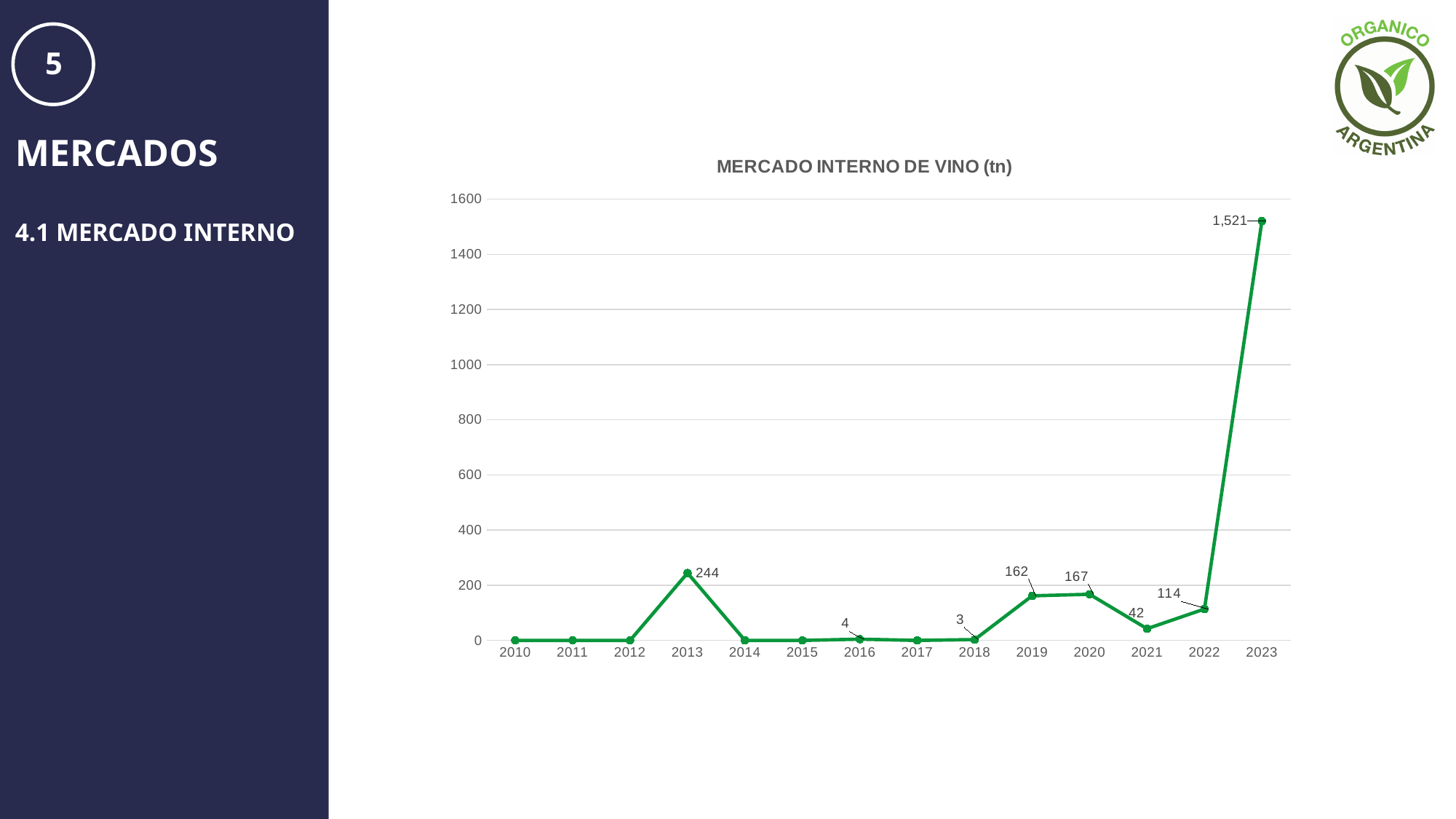
What is the value for 2021 in the chart? 42 What is the value for 2013 in the chart? 244 Which year has the larger value, 2013 or 2022? 2013 How many years are plotted on the x axis of the chart? 14 Which year has the highest value in the chart? 2023 What is the difference between the values for 2023 and 2022? 1,407 Is the value for 2023 greater or less than 1400? greater What is the difference between the values for 2020 and 2019? 5 What kind of chart is shown on the slide? line chart What is the title of the chart? MERCADO INTERNO DE VINO (tn) What is the value for 2023 in the MERCADO INTERNO DE VINO (tn) chart? 1,521 What is the value for 2022 in the chart? 114